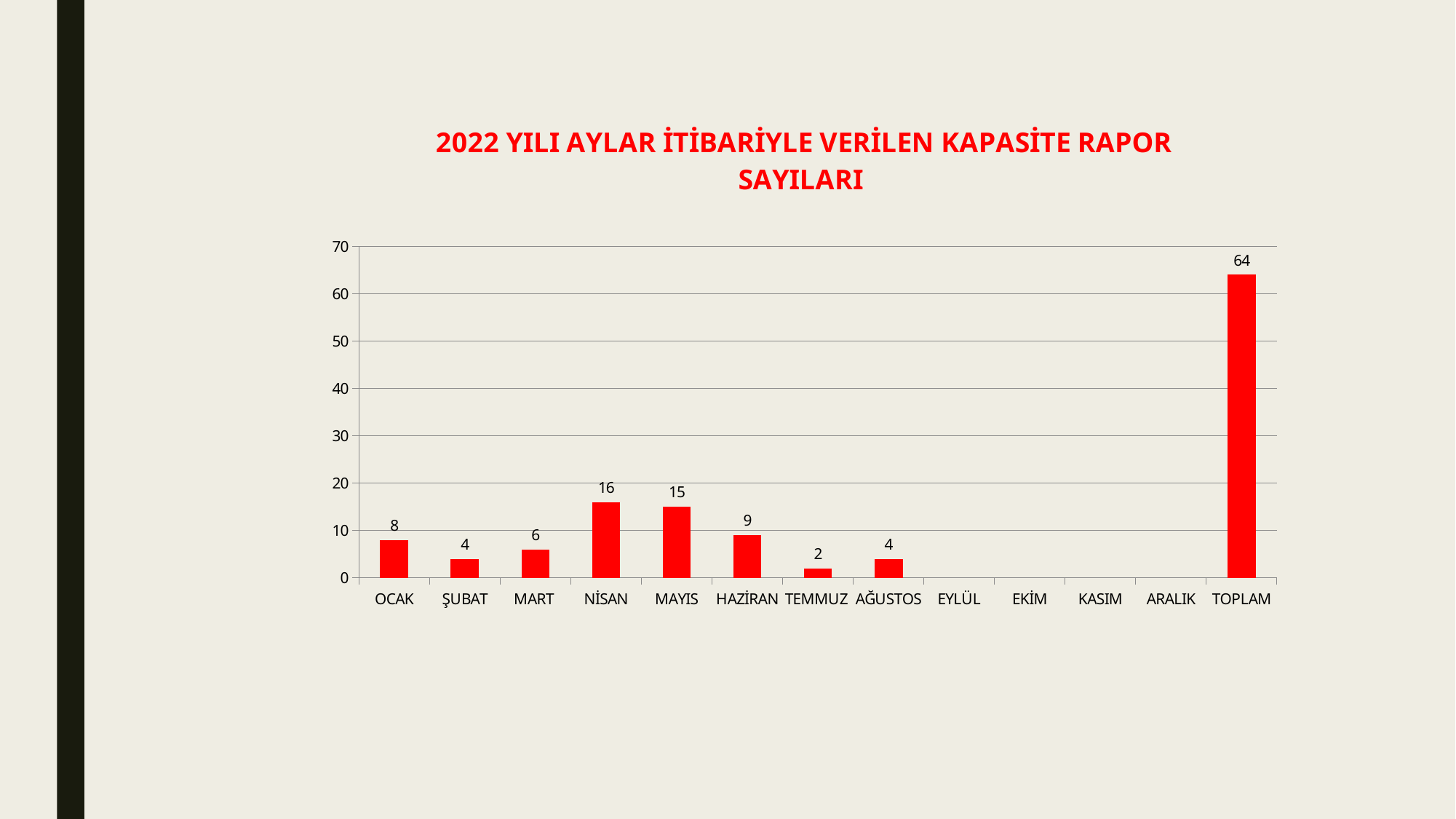
What is the difference between the values for NİSAN and MAYIS? 1 What is the value for TOPLAM? 64 Which category has the highest bar? TOPLAM What is the difference between the values for OCAK and ŞUBAT? 4 How many categories are shown on the x axis? 13 Which is larger, the value for HAZİRAN or the value for MART? HAZİRAN What is the value for TEMMUZ? 2 What is the value for OCAK? 8 Is the value for TOPLAM greater or less than 60? greater What is the value for NİSAN? 16 Among the months with a bar shown, which month has the lowest value? TEMMUZ What kind of chart is shown on the slide? bar chart